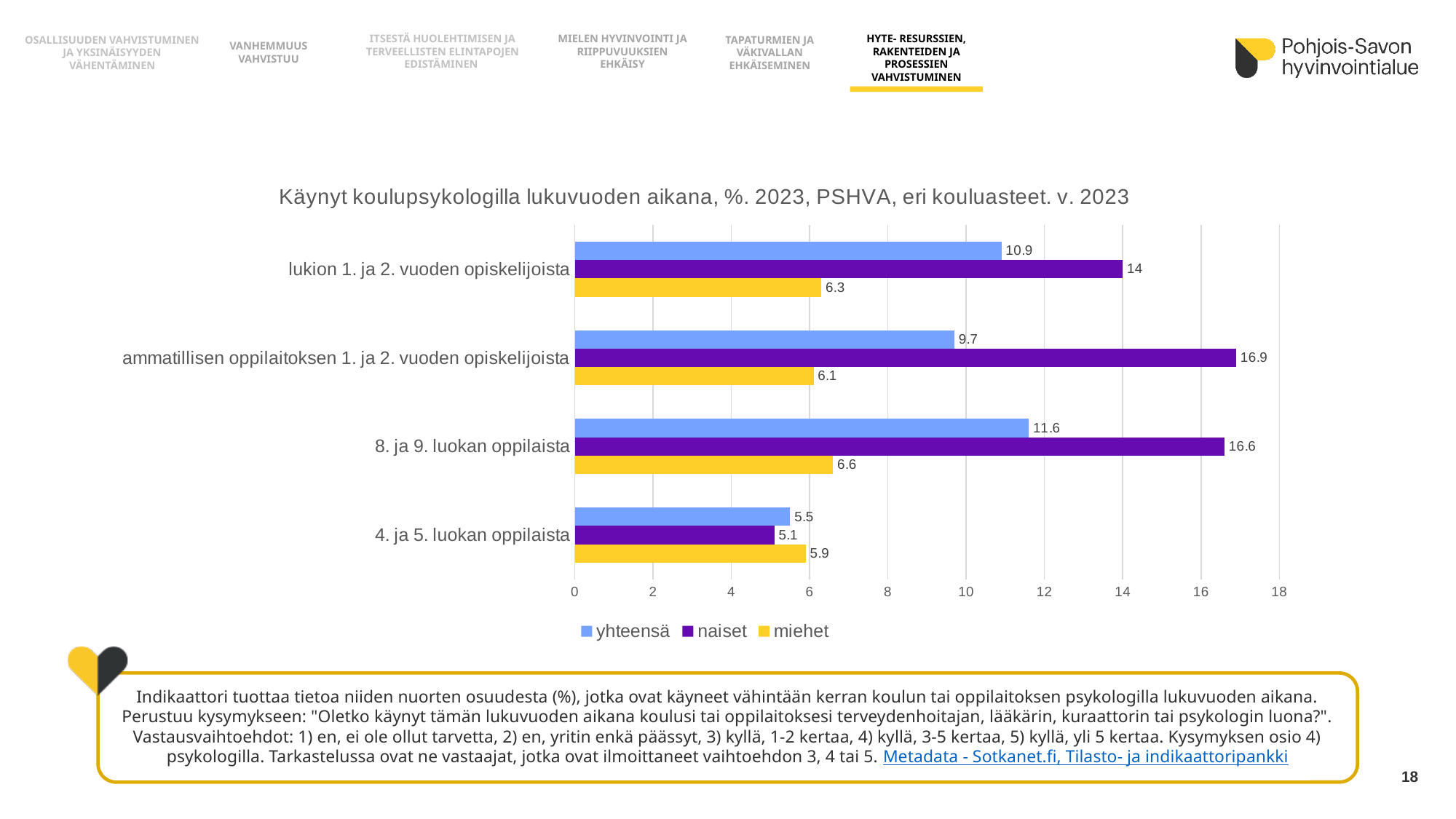
What is the miehet value for lukion 1. ja 2. vuoden opiskelijoista? 6.3 For 4. ja 5. luokan oppilaista, which is larger: the naiset value or the miehet value? miehet What is the value for naiset among ammatillisen oppilaitoksen 1. ja 2. vuoden opiskelijoista? 16.9 Is the naiset value for lukion 1. ja 2. vuoden opiskelijoista greater or less than 12? greater Which category has the highest naiset value? ammatillisen oppilaitoksen 1. ja 2. vuoden opiskelijoista How many categories (school levels) are shown on the chart? 4 What kind of chart is shown on the slide? bar chart What is the yhteensä value for 8. ja 9. luokan oppilaista? 11.6 How many series does the legend list? 3 What is the difference between the naiset and miehet values for 8. ja 9. luokan oppilaista? 10 Which category has the lowest yhteensä value? 4. ja 5. luokan oppilaista Which colour represents the miehet series in the chart? yellow